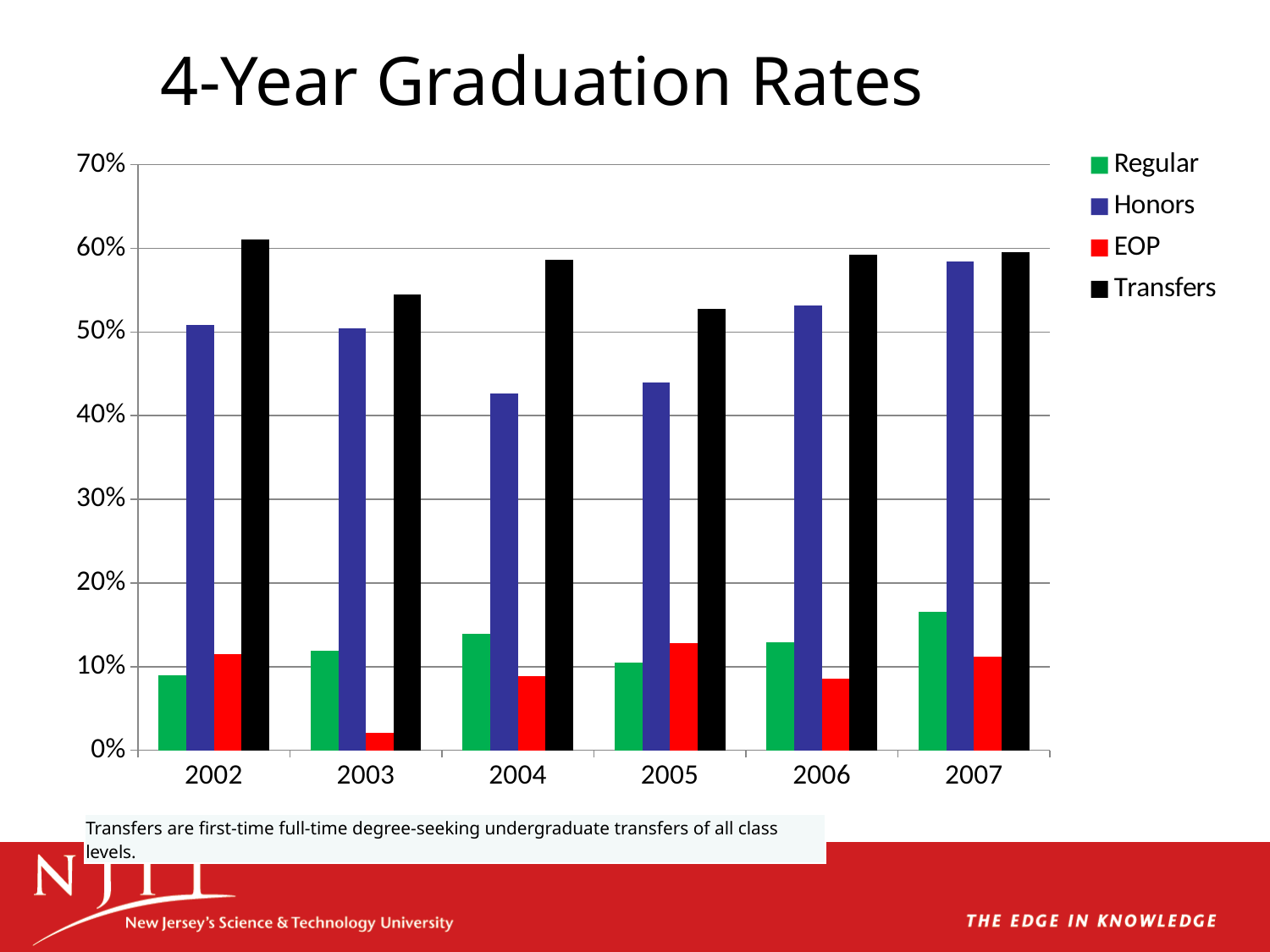
Which year has the highest Honors graduation rate? 2007 How many series does the legend list? 4 Is the EOP value for 2003 greater or less than 10%? less Is the Regular value for 2007 greater or less than 10%? greater In 2003, which is larger, the Regular rate or the EOP rate? Regular Is the Honors value for 2004 greater or less than 40%? greater Which year has the lowest EOP graduation rate? 2003 Which year has the highest Regular graduation rate? 2007 What kind of chart is shown on the slide? Bar chart How many years are shown on the x axis? 6 What colour represents the Transfers series in the legend? Black In 2002, which is larger, the Honors rate or the Transfers rate? Transfers